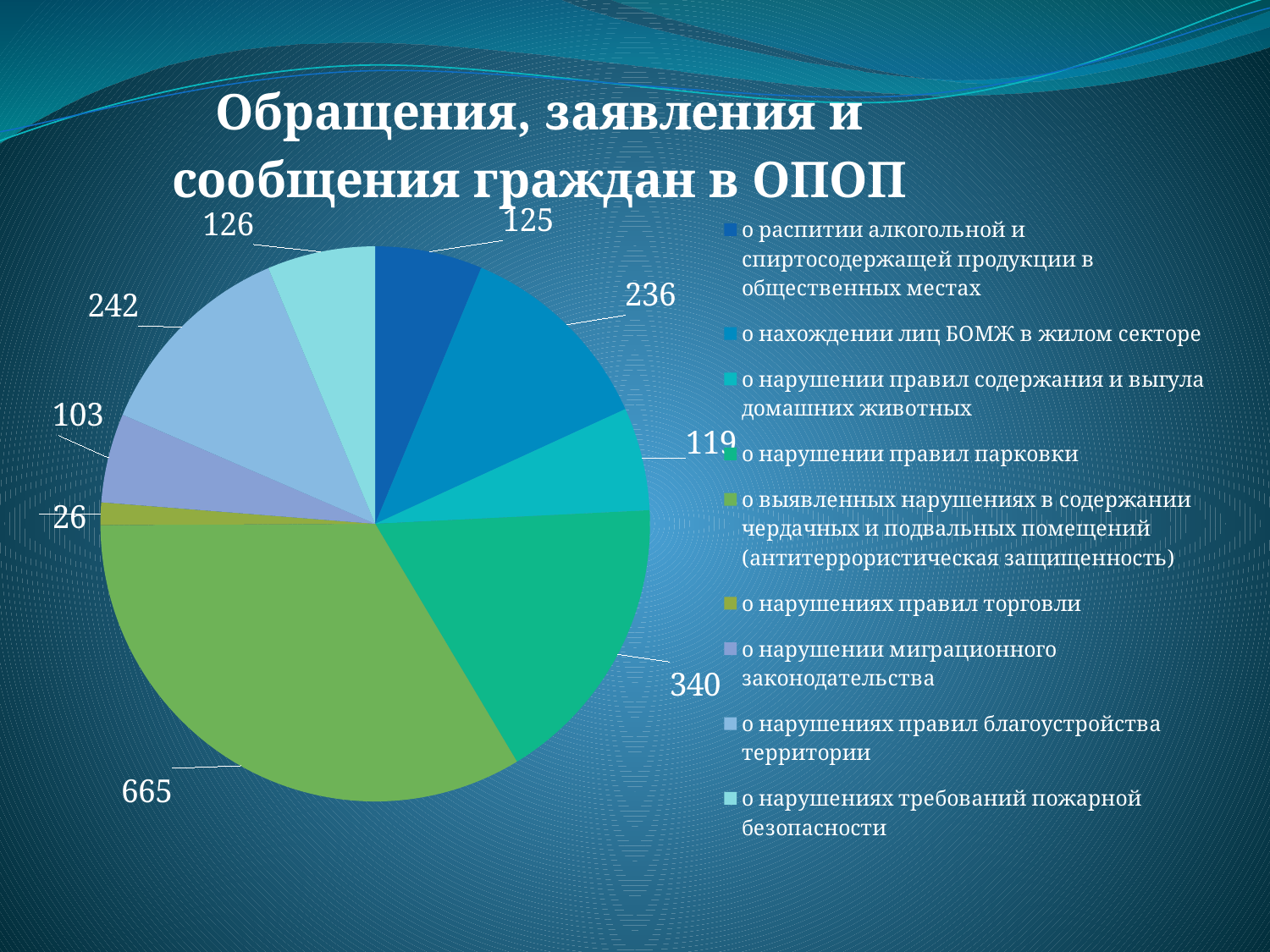
What is the difference between the values for "о нарушении правил парковки" and "о нахождении лиц БОМЖ в жилом секторе"? 104 What is the value for "о нахождении лиц БОМЖ в жилом секторе"? 236 Which category has the smallest value? о нарушениях правил торговли Which category has the largest value? о выявленных нарушениях в содержании чердачных и подвальных помещений (антитеррористическая защищенность) What is the value for "о нарушениях правил благоустройства территории"? 242 What is the value for "о нарушении правил парковки"? 340 What is the difference between the values for "о нарушениях правил благоустройства территории" and "о нарушениях требований пожарной безопасности"? 116 What is the title of the chart? Обращения, заявления и сообщения граждан в ОПОП How many categories does the pie chart have? 9 What is the value for "о нарушении миграционного законодательства"? 103 Which is larger: the value for "о нахождении лиц БОМЖ в жилом секторе" or for "о распитии алкогольной и спиртосодержащей продукции в общественных местах"? о нахождении лиц БОМЖ в жилом секторе What kind of chart is shown on the slide? pie chart